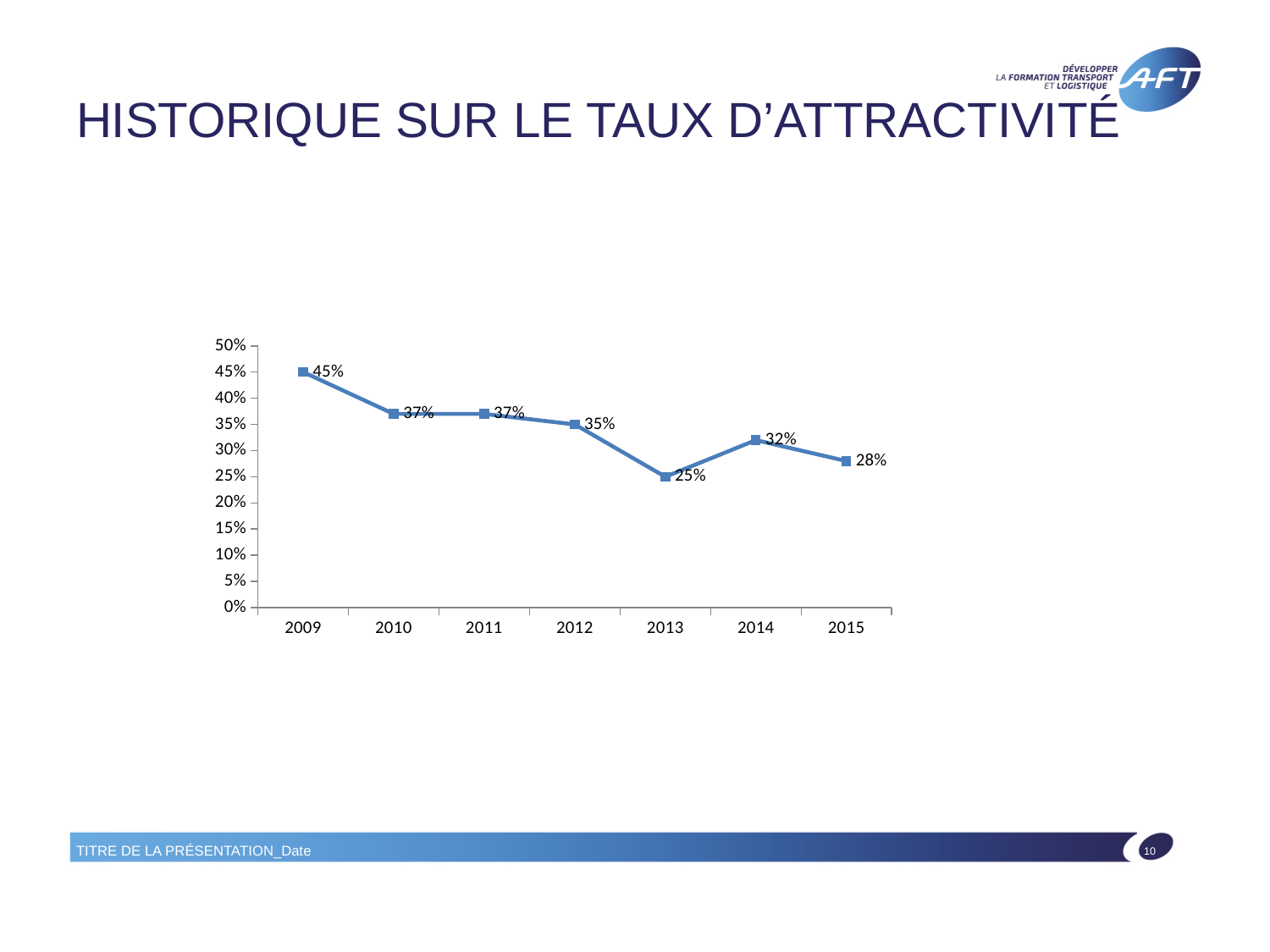
What kind of chart is shown on the slide? line chart Which year has the highest value? 2009 What is the value for 2009? 45% Do the values generally rise or fall from 2009 to 2015? fall What is the value for 2015? 28% What is the difference between the values for 2014 and 2013? 7% Which is larger, the value for 2014 or the value for 2015? 2014 What is the value for 2013? 25% What is the value for 2012? 35% What is the difference between the values for 2009 and 2015? 17% Which year has the lowest value? 2013 How many years are plotted on the chart? 7